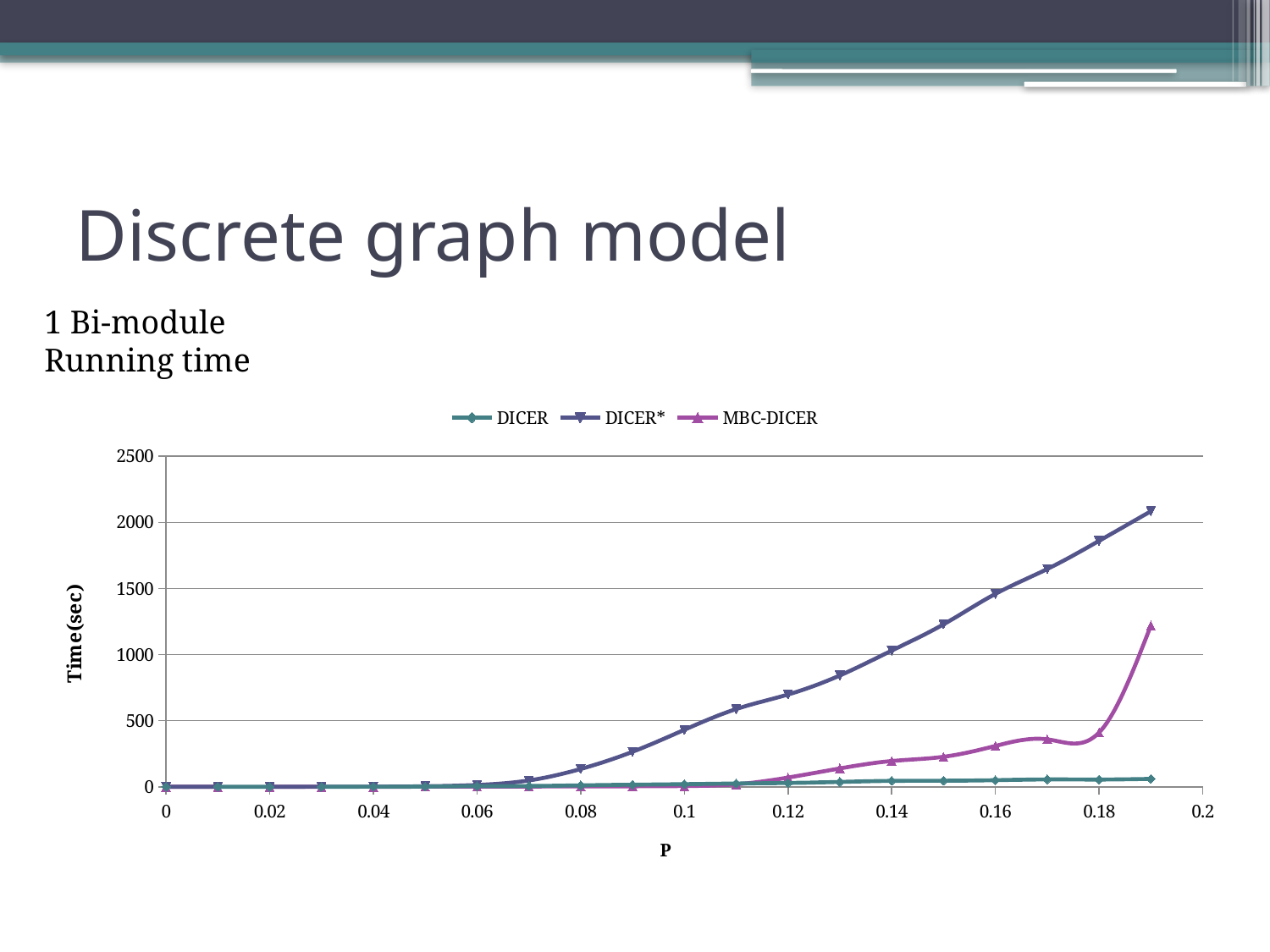
Is the value for DICER* at p = 0.15 greater or less than 1000? greater Is the value for MBC-DICER at p = 0.19 greater or less than 1500? less Which series has the highest value at p = 0.19? DICER* Which series has the lowest value at p = 0.19? DICER At p = 0.18, which series has the larger value, DICER* or MBC-DICER? DICER* Does the DICER* series rise or fall as p increases from 0.08 to 0.19? rise Is the value for DICER* at p = 0.19 greater or less than 1500? greater What kind of chart is shown on the slide? line chart What are the names of the series in the legend? DICER, DICER*, MBC-DICER How many series does the legend list? 3 What is the label of the vertical axis? Time(sec)